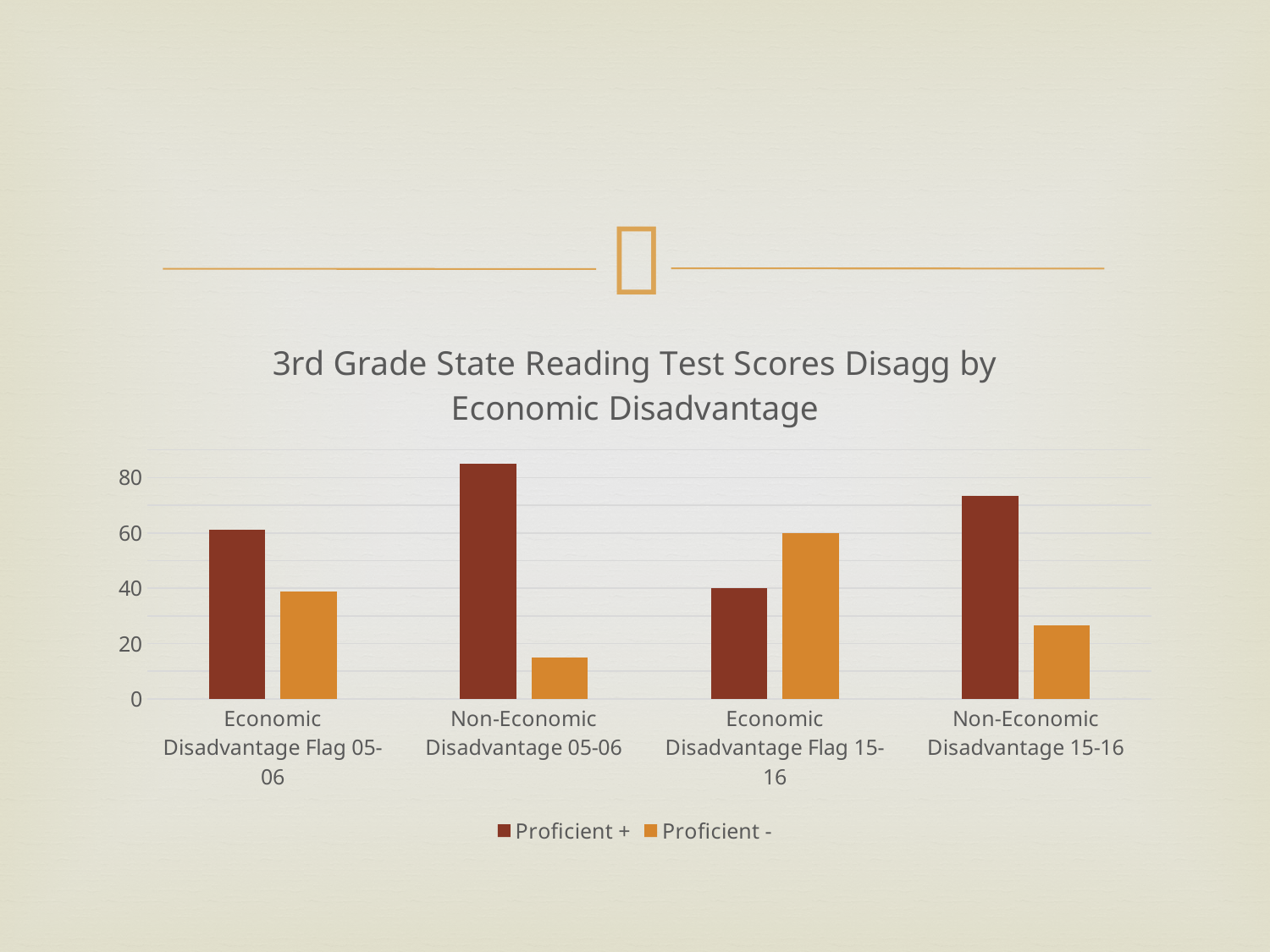
Is the Proficient - value for Non-Economic Disadvantage 05-06 greater or less than 20? less Which category has the highest Proficient + value? Non-Economic Disadvantage 05-06 Which category has the highest Proficient - value? Economic Disadvantage Flag 15-16 How many categories are shown on the x axis? 4 What is the title of the chart? 3rd Grade State Reading Test Scores Disagg by Economic Disadvantage Which series is shown in orange in the legend? Proficient - Which category has the lowest Proficient - value? Non-Economic Disadvantage 05-06 Which is larger for Economic Disadvantage Flag 15-16, the Proficient + value or the Proficient - value? Proficient - How many series does the legend list? 2 Is the Proficient + value for Non-Economic Disadvantage 05-06 greater or less than 80? greater What kind of chart is shown on the slide? bar chart Which category has the lowest Proficient + value? Economic Disadvantage Flag 15-16